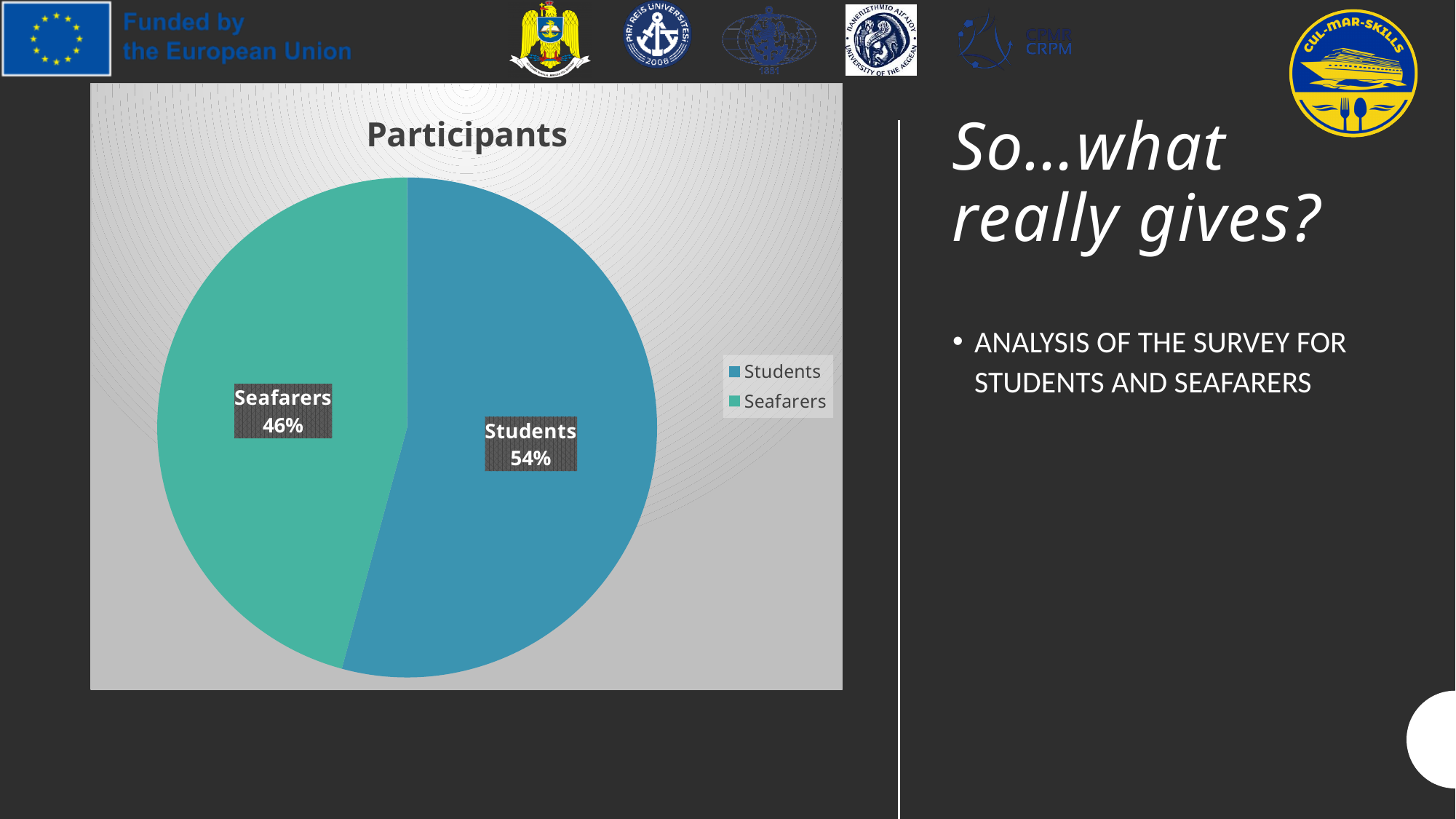
Which category has the largest share of the pie? Students What share of participants are Students? 54% Which category has the smallest share of the pie? Seafarers What is the difference in percentage points between the Students and Seafarers shares? 8 Which colour represents Seafarers in the pie chart? green What kind of chart is shown on the slide? pie chart Is the share for Students greater or less than 50%? greater Which is larger, the share for Students or the share for Seafarers? Students How many slices does the pie chart have? 2 What is the title of the chart? Participants How many entries does the legend list? 2 What share of participants are Seafarers? 46%